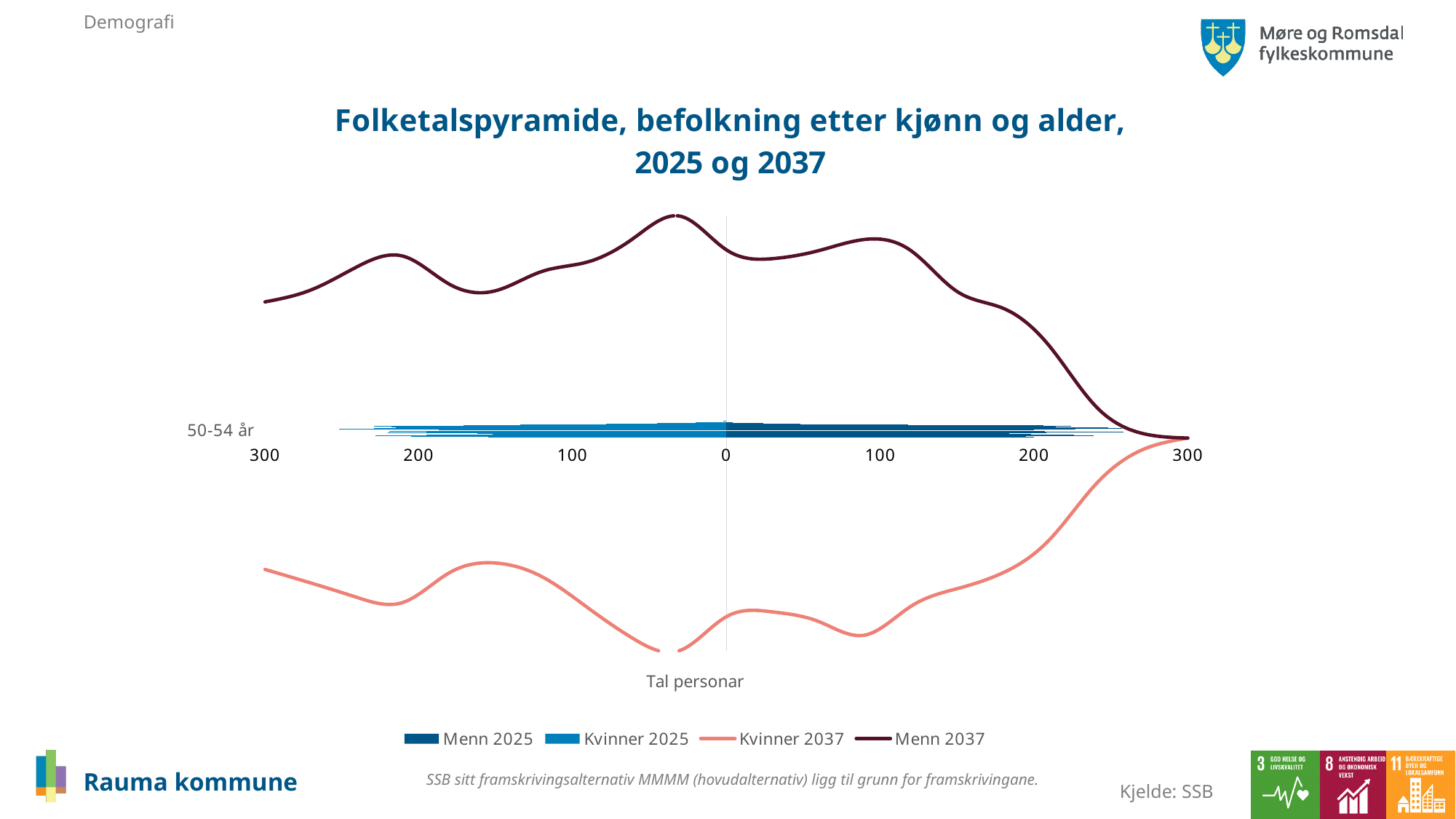
What is the highest value shown on the horizontal axis of the chart? 300 What is the title of the chart? Folketalspyramide, befolkning etter kjønn og alder, 2025 og 2037 Which age group label is readable on the vertical axis of the chart? 50-54 år What label is shown on the horizontal axis of the chart? Tal personar How many series does the chart legend list? 4